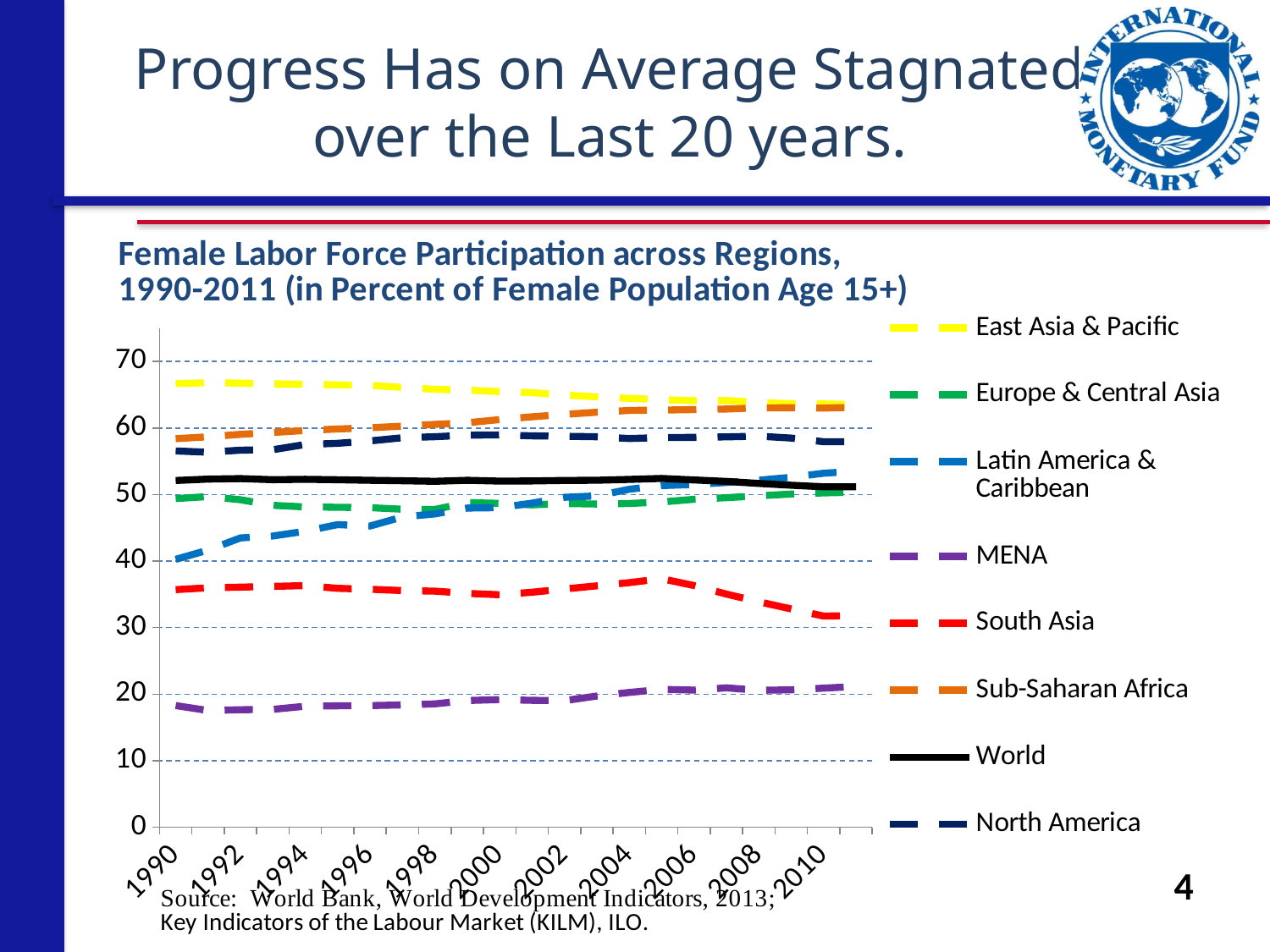
Is the value for South Asia in 2010 greater or less than 40? less Which region has the highest female labor force participation across the whole period? East Asia & Pacific Is the value for Latin America & Caribbean in 1990 greater or less than 50? less What kind of chart is shown on the slide? line chart Is the value for MENA in 1990 greater or less than 20? less Which series is drawn as a solid black line? World In 1990, which is larger: the value for Sub-Saharan Africa or the value for South Asia? Sub-Saharan Africa Which region has the lowest female labor force participation across the whole period? MENA Does the East Asia & Pacific line rise or fall from 1990 to 2010? fall How many series does the legend list? 8 Does the Latin America & Caribbean line rise or fall from 1990 to 2010? rise